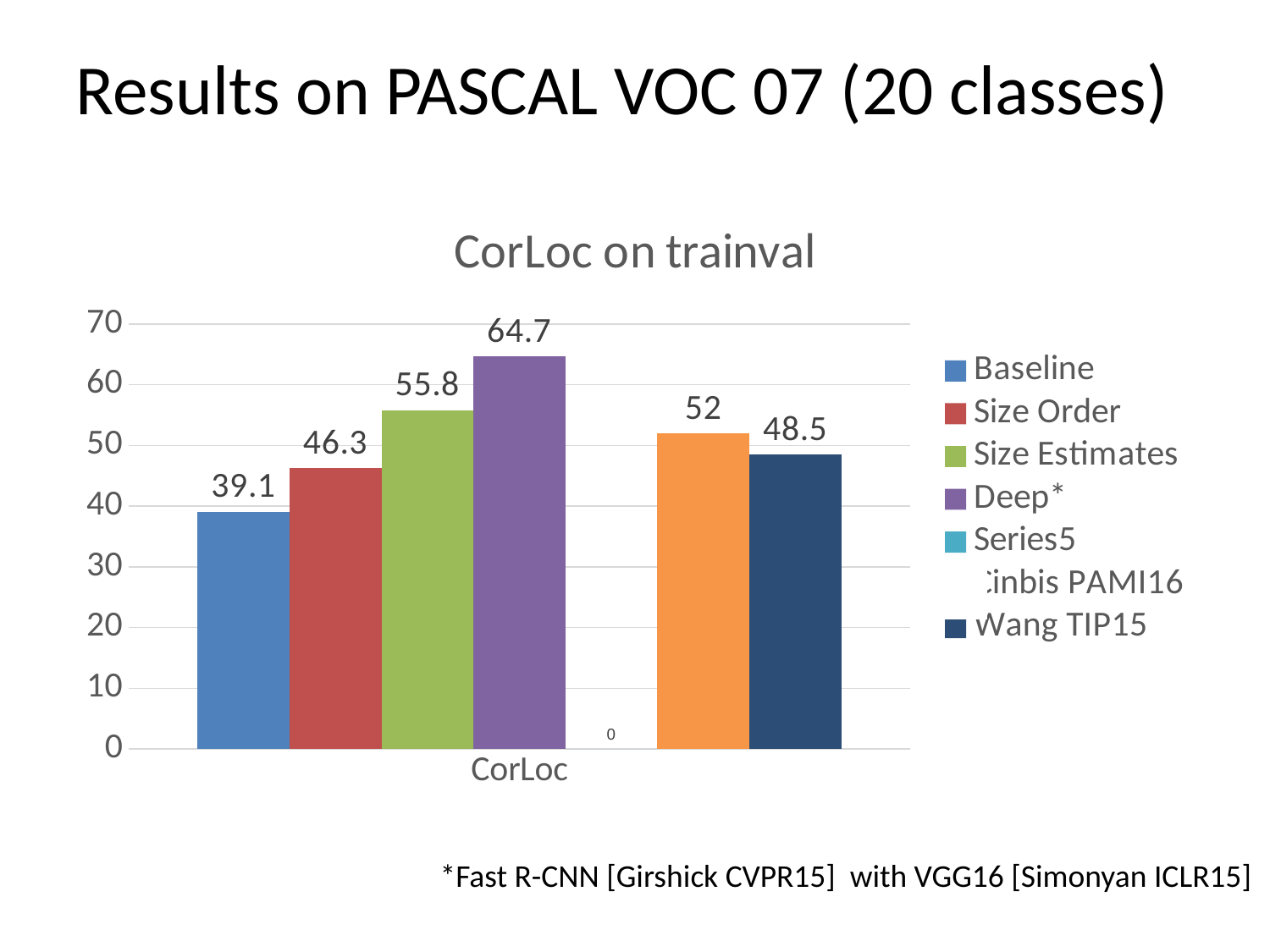
What is the CorLoc value for Size Order? 46.3 What is the CorLoc value for Baseline? 39.1 What is the CorLoc value for Wang TIP15? 48.5 What is the difference between the CorLoc values of Deep* and Baseline? 25.6 What is the CorLoc value for Size Estimates? 55.8 What is the CorLoc value for Deep*? 64.7 What is the difference between the CorLoc values of Size Estimates and Size Order? 9.5 Which has a higher CorLoc value, Size Order or Wang TIP15? Wang TIP15 How many series does the legend list? 7 What kind of chart is shown on the slide? bar chart Which series has the highest CorLoc value? Deep* What is the title of the chart? CorLoc on trainval